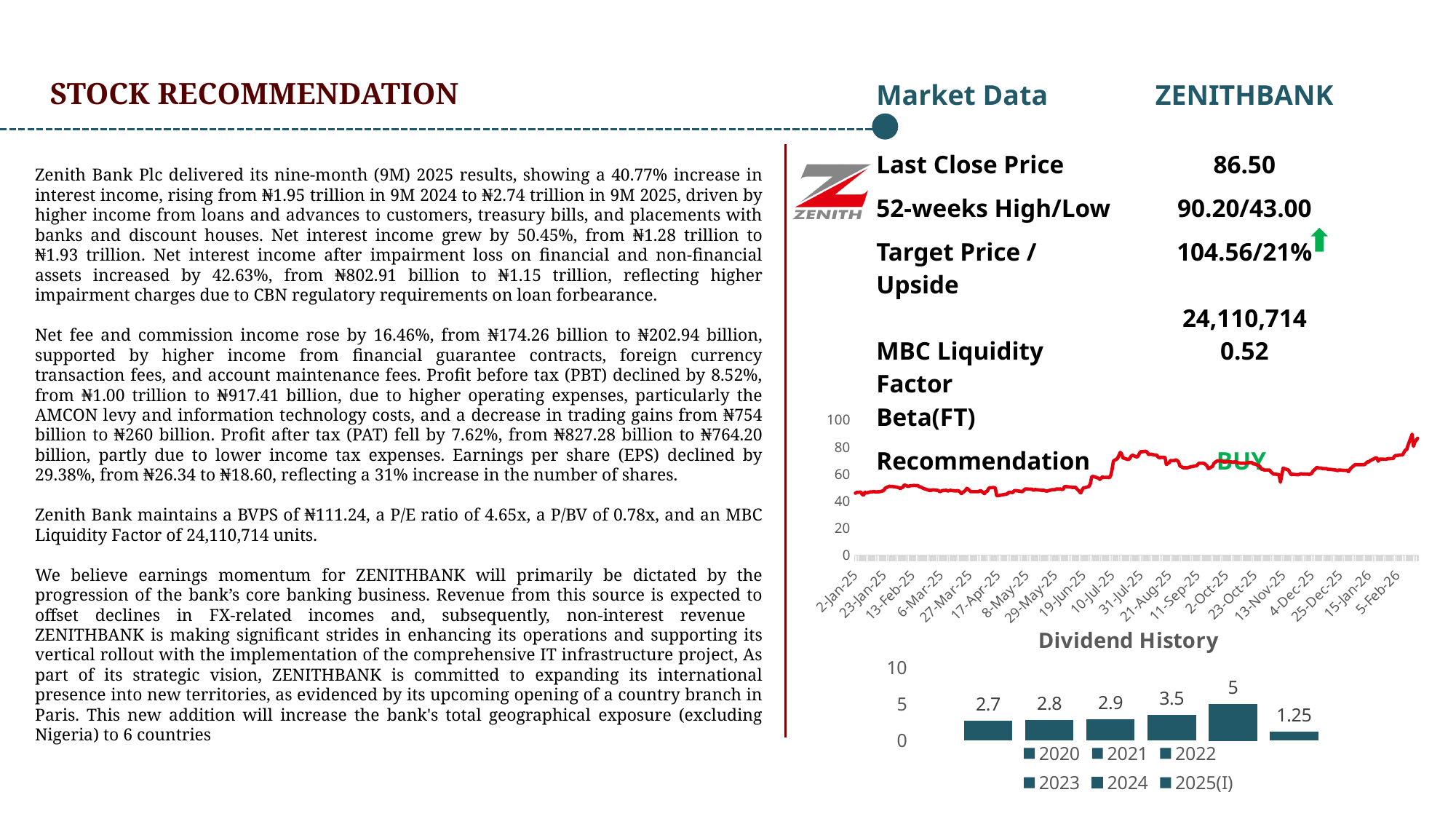
In the Dividend History chart, which year has the lowest dividend? 2025(I) How many entries does the legend of the Dividend History chart list? 6 What kind of chart is the Dividend History chart? bar chart In the Dividend History chart, what is the dividend value for 2023? 3.5 What kind of chart is the share price chart above the Dividend History chart? line chart In the Dividend History chart, what is the dividend value for 2025(I)? 1.25 In the Dividend History chart, which is larger, the dividend for 2022 or for 2021? 2022 How many bars are shown in the Dividend History chart? 6 In the Dividend History chart, what is the dividend value for 2024? 5 In the Dividend History chart, which year has the highest dividend? 2024 In the share price line chart above the Dividend History chart, is the value at 5-Feb-26 greater or less than 80? less In the Dividend History chart, what is the difference between the 2024 and 2023 dividends? 1.5